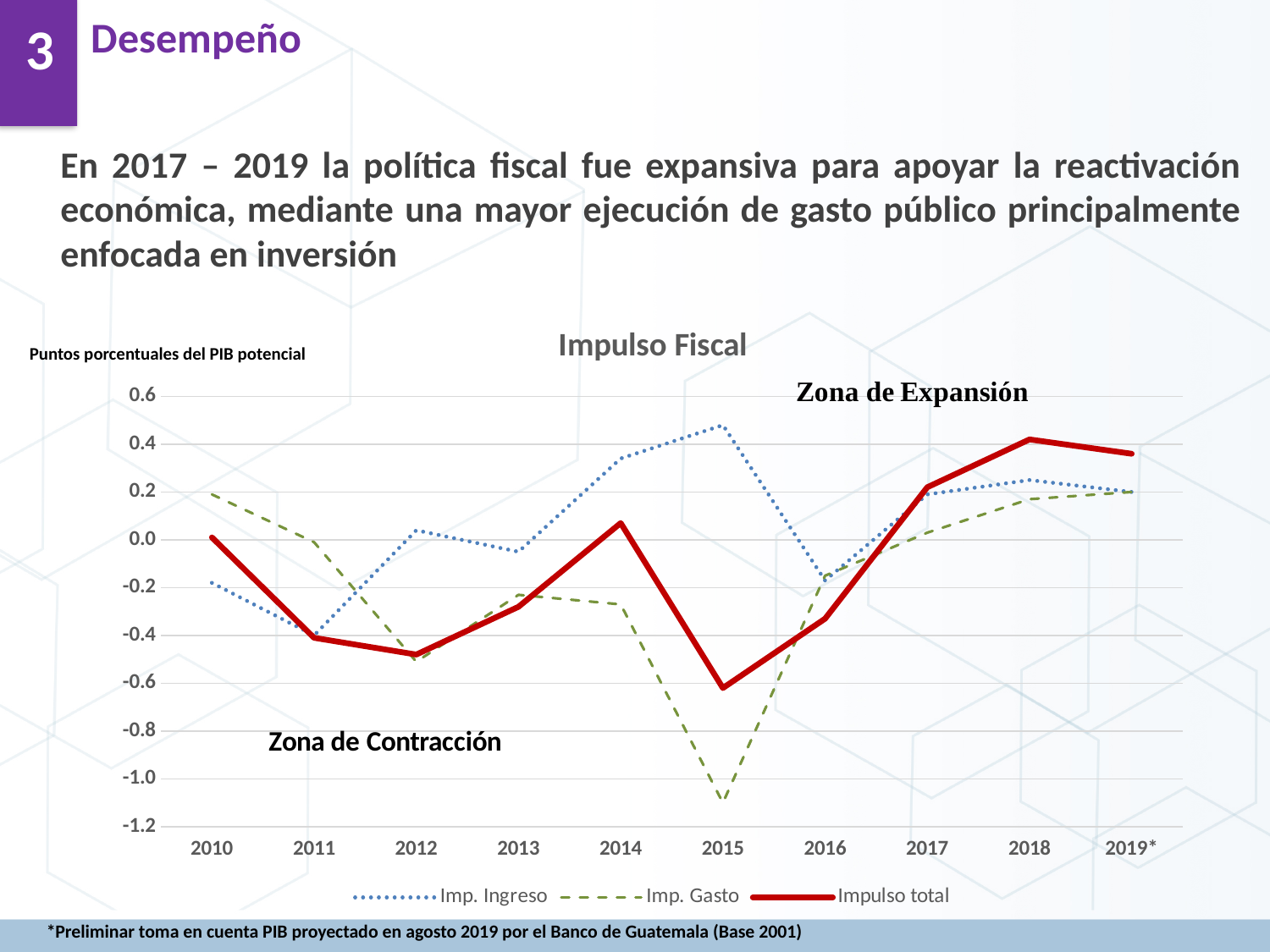
Which is larger in 2015, Imp. Ingreso or Imp. Gasto? Imp. Ingreso What is the title of the chart? Impulso Fiscal Does the Impulso total series rise or fall from 2015 to 2018? rise Is the value of Impulso total in 2015 greater or less than -0.4? less What unit label is shown above the y axis? Puntos porcentuales del PIB potencial How many years are shown on the x axis? 10 In which year is the Imp. Gasto series at its lowest? 2015 How many series does the legend list? 3 Is the value of Impulso total in 2018 greater or less than 0.2? greater In which year is the Impulso total series at its highest? 2018 In which year is the Impulso total series at its lowest? 2015 What kind of chart is shown on the slide? line chart